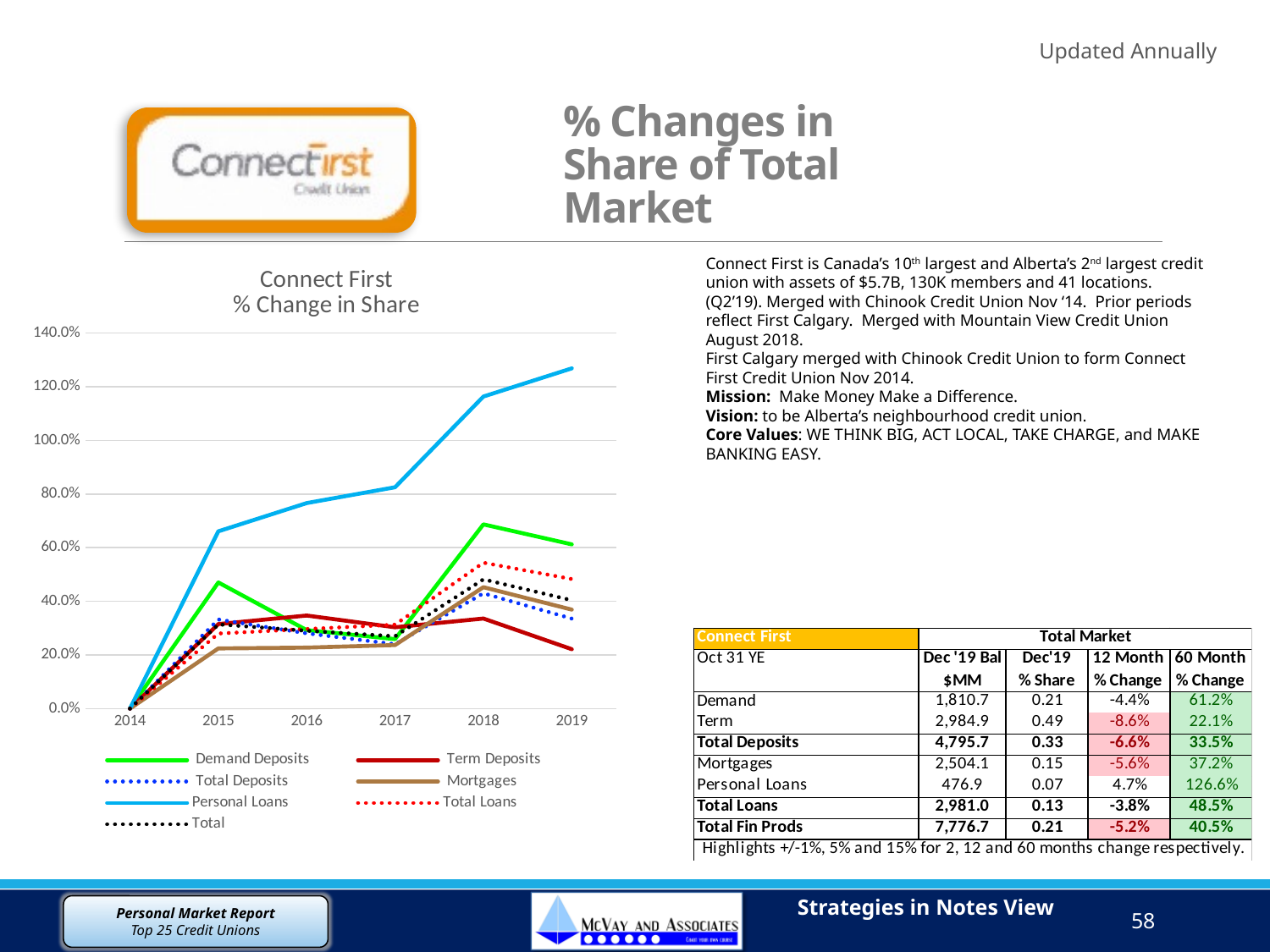
Does the Personal Loans line rise or fall from 2014 to 2019? rise Which series has the highest value in 2019? Personal Loans How many series does the chart legend list? 7 What is the title of the chart? Connect First % Change in Share In 2019, which is larger: Personal Loans or Demand Deposits? Personal Loans Is the value for Personal Loans in 2019 greater or less than 120.0%? greater What kind of chart is shown on the slide? line chart How many years are plotted along the x axis of the chart? 6 Which series has the lowest value in 2019? Term Deposits Is the value for Personal Loans in 2018 greater or less than 100.0%? greater Is the value for Term Deposits in 2019 greater or less than 40.0%? less